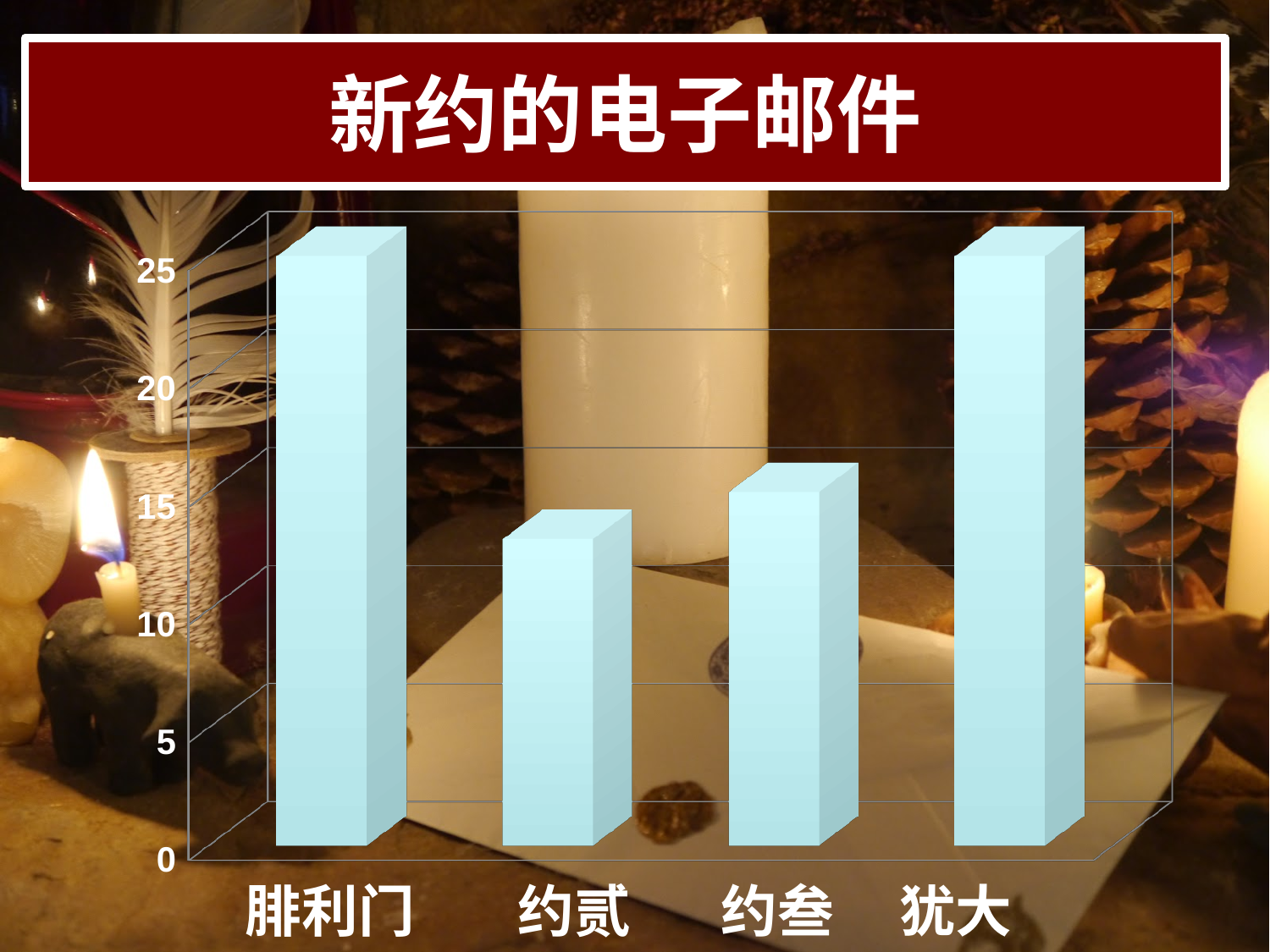
Is the value for 腓利门 greater or less than 20? greater Is the value for 约贰 greater or less than 10? greater What is the highest value labelled on the vertical axis of the chart? 25 What is the title of the chart? 新约的电子邮件 Which is larger, the value for 约贰 or the value for 约叁? 约叁 Is the value for 约叁 greater or less than 10? greater Which category has the lowest bar in the chart? 约贰 What kind of chart is shown on the slide? bar chart How many categories are shown on the x axis of the chart? 4